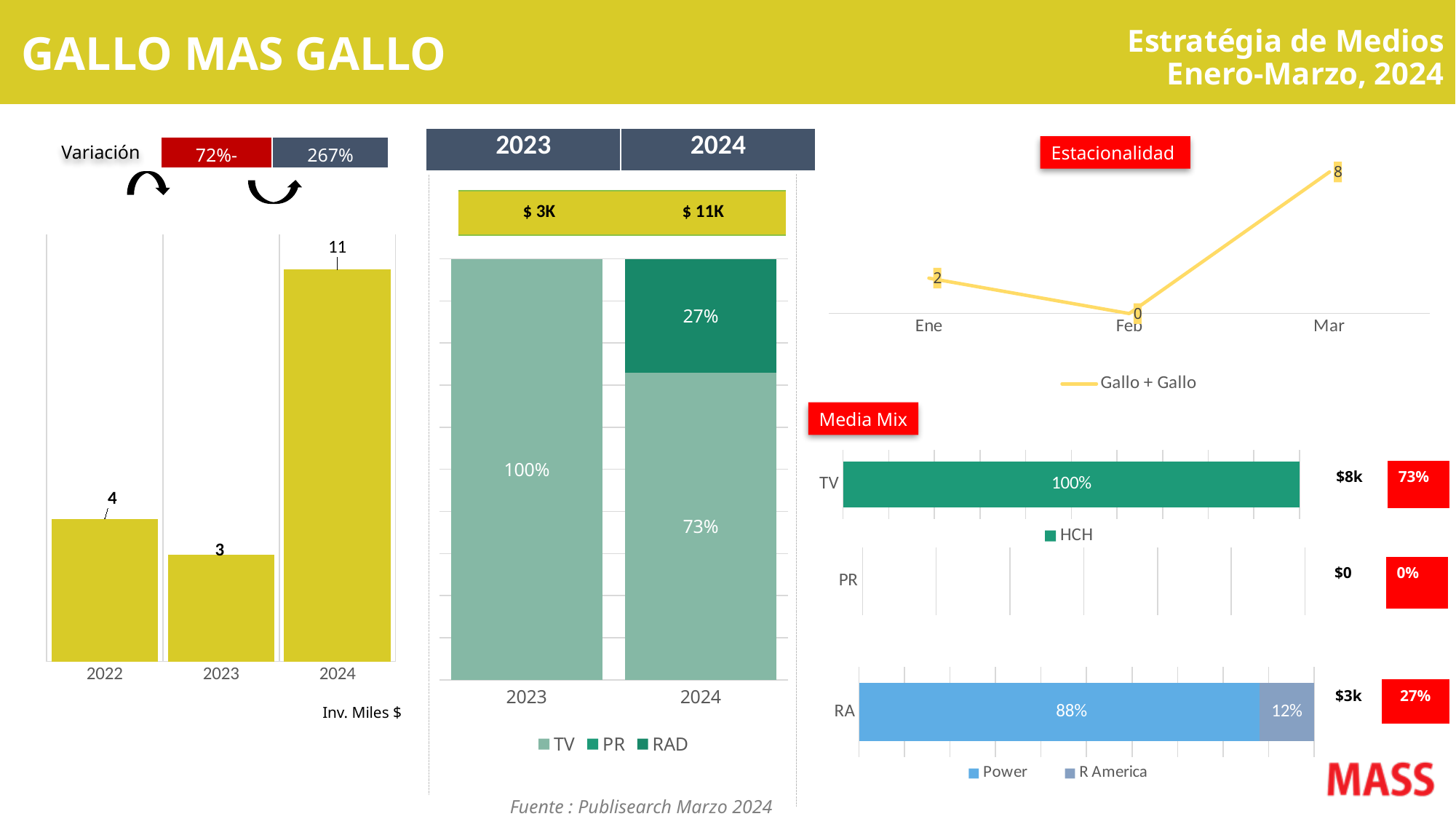
In the Estacionalidad line chart, which month has the lowest value? Feb In the stacked bar chart in the middle, how many series does the legend list? 3 In the Media Mix chart, what percentage of RA does Power represent? 88% In the bar chart on the left (Inv. Miles $), how many years are shown? 3 What type of chart is the Estacionalidad chart? Line chart In the bar chart on the left (Inv. Miles $), what is the value for 2024? 11 In the stacked bar chart in the middle, what percentage does TV represent in 2023? 100% In the bar chart on the left (Inv. Miles $), which year has the lowest value? 2023 In the stacked bar chart in the middle (2023 vs 2024), what percentage does TV represent in 2024? 73% In the Media Mix chart, what is the name of the series shown for TV? HCH In the Estacionalidad line chart, what is the value for Mar? 8 In the bar chart on the left (Inv. Miles $), what is the difference between the 2024 and 2022 values? 7